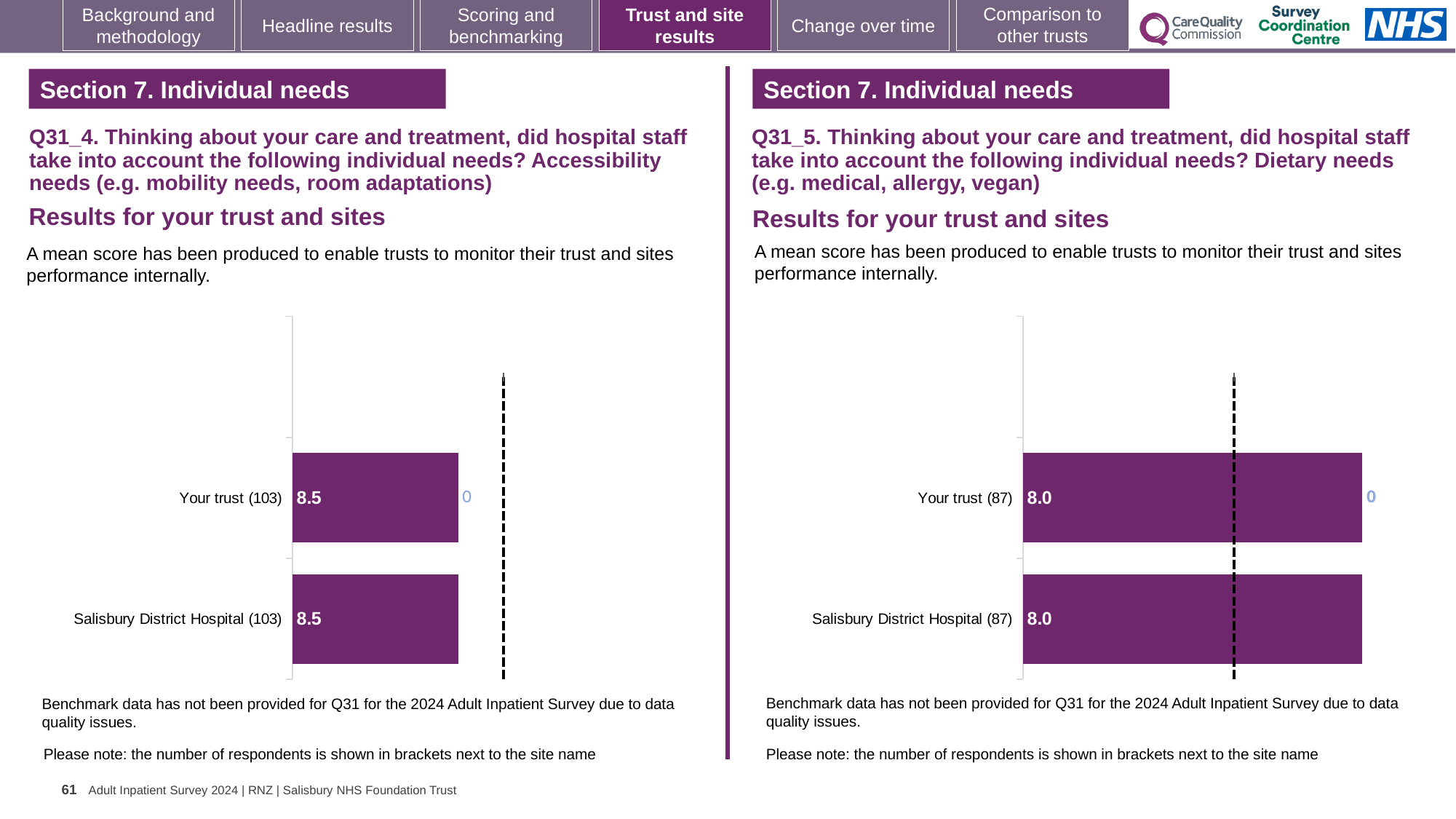
On the right chart (Q31_5, dietary needs), what is the mean score for Your trust? 8.0 On the left chart (Q31_4, accessibility needs), what is the mean score for Salisbury District Hospital? 8.5 On the left chart (Q31_4), how many respondents are shown in brackets for Your trust? 103 What kind of chart is used on the left side of the slide (Q31_4)? Bar chart On the right chart (Q31_5), how many respondents are shown in brackets for Salisbury District Hospital? 87 On the left chart (Q31_4), what is the difference between the mean score for Your trust and the mean score for Salisbury District Hospital? 0.0 How many bars are plotted on the right chart (Q31_5)? 2 On the right chart (Q31_5), what is the difference between the mean score for Your trust and the mean score for Salisbury District Hospital? 0.0 On the right chart (Q31_5, dietary needs), what is the mean score for Salisbury District Hospital? 8.0 On the left chart (Q31_4, accessibility needs), what is the mean score for Your trust? 8.5 How many bars are plotted on the left chart (Q31_4)? 2